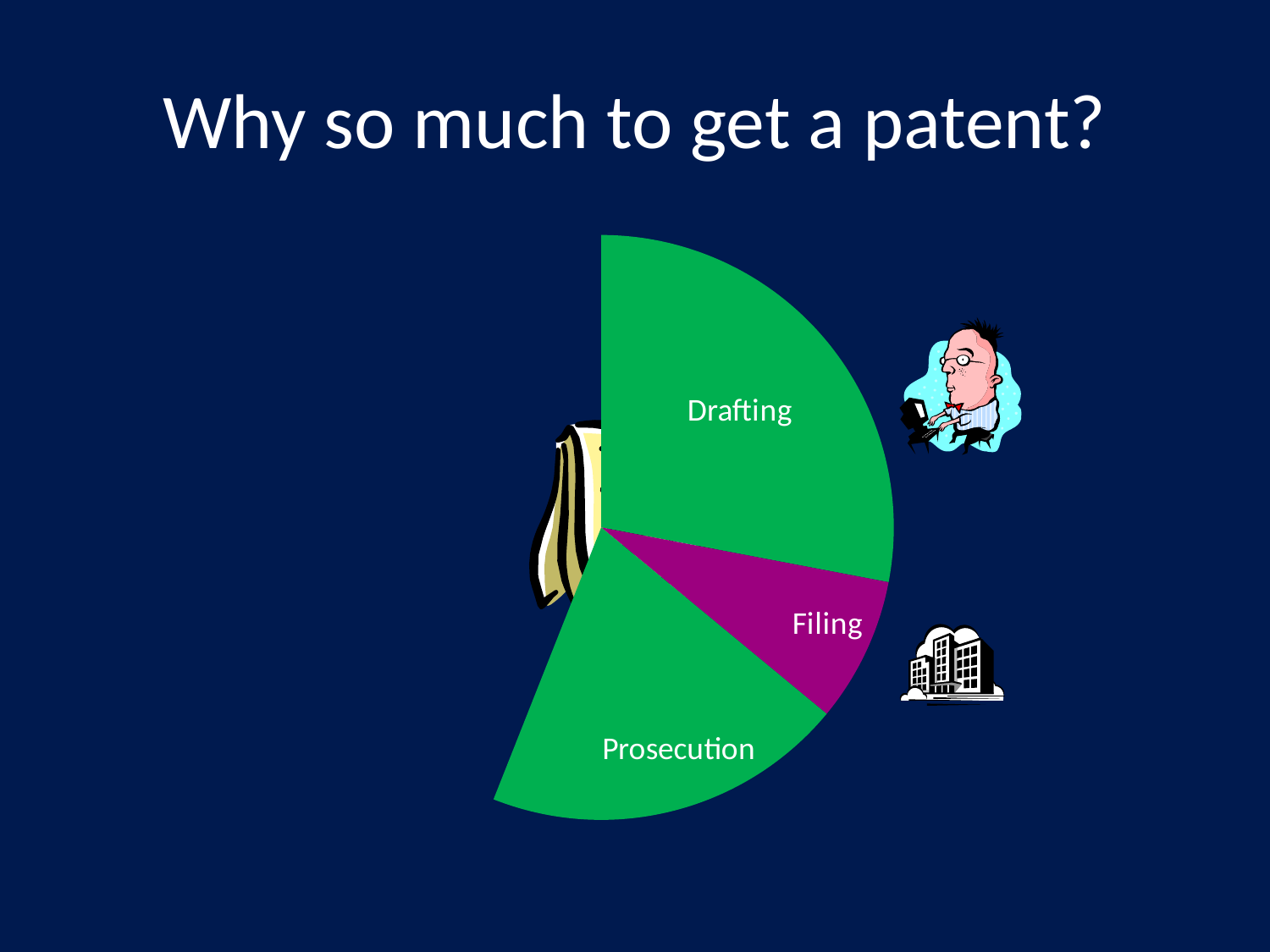
Which slice is larger, Drafting or Prosecution? Drafting What are the labels of the three slices in the pie chart? Drafting, Filing, Prosecution How many labeled slices does the pie chart have? 3 What kind of chart is shown on the slide? pie chart What is the title of the slide containing the pie chart? Why so much to get a patent? Which labeled slice of the pie chart is the smallest? Filing Which slice is larger, Prosecution or Filing? Prosecution What colour is the Filing slice of the pie chart? purple Which slice is larger, Drafting or Filing? Drafting